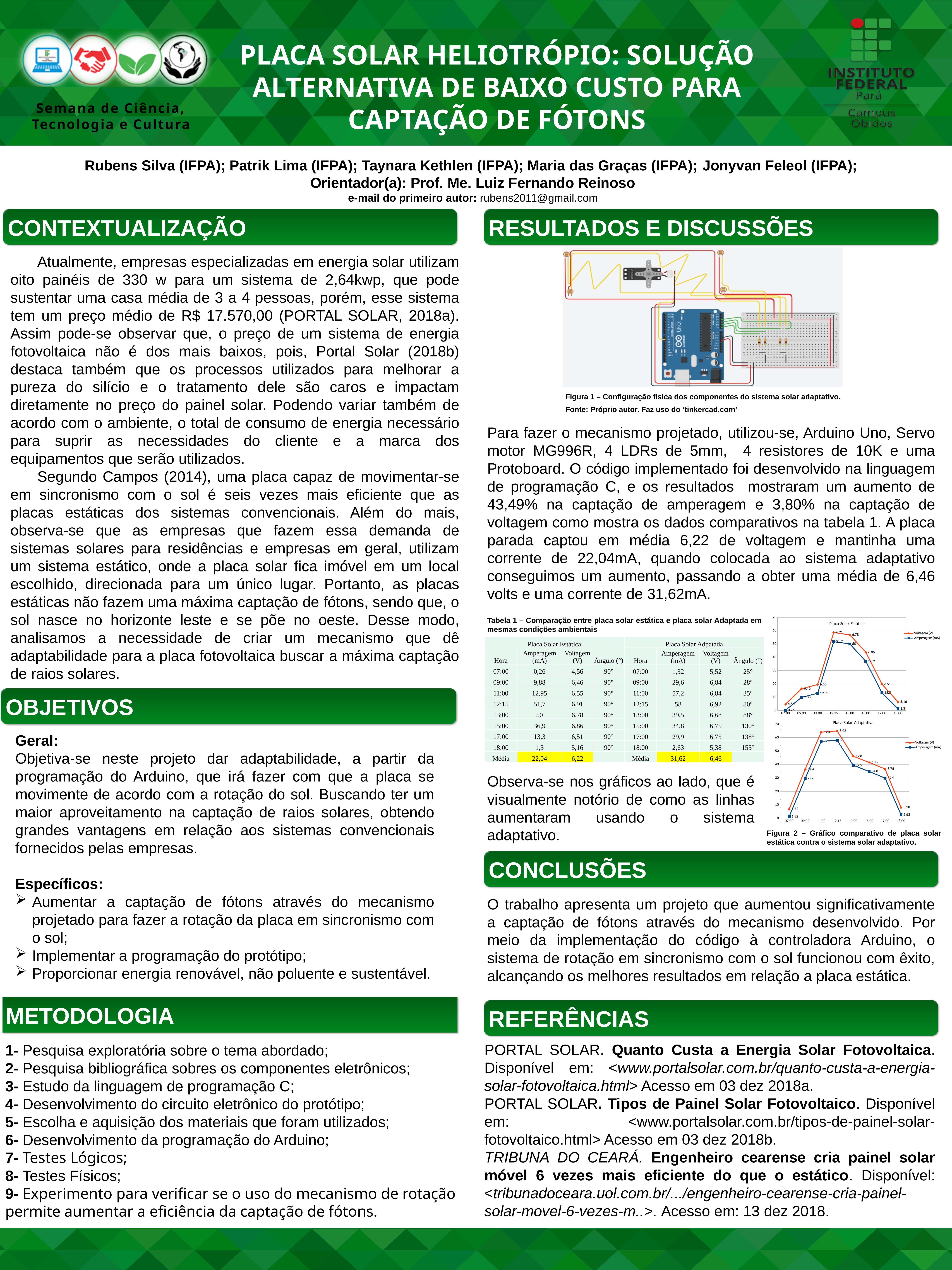
How many series does the legend of the 'Placa Solar Adaptativa' chart list? 2 In the 'Placa Solar Adaptativa' chart, at which time is the Amperagem (mA) value highest? 12:15 How many time points are plotted along the x axis of the 'Placa Solar Estática' chart? 8 What kind of chart is the 'Placa Solar Estática' chart? line chart In the 'Placa Solar Estática' chart, what is the Amperagem (mA) value at 12:15? 51.7 In the 'Placa Solar Estática' chart, at which time is the Amperagem (mA) value lowest? 07:00 In the 'Placa Solar Adaptativa' chart, what is the Voltagem (V) value at 18:00? 5.38 In the 'Placa Solar Estática' chart, what is the difference between the Amperagem (mA) values at 12:15 and 13:00? 1.7 In the 'Placa Solar Estática' chart, is the Amperagem (mA) value at 15:00 greater or less than 30? greater In the 'Placa Solar Adaptativa' chart, does the Amperagem (mA) series rise or fall from 13:00 to 18:00? fall In the 'Placa Solar Adaptativa' chart, which is larger: the Amperagem (mA) value at 11:00 or at 13:00? 11:00 In the 'Placa Solar Adaptativa' chart, what is the Amperagem (mA) value at 12:15? 58